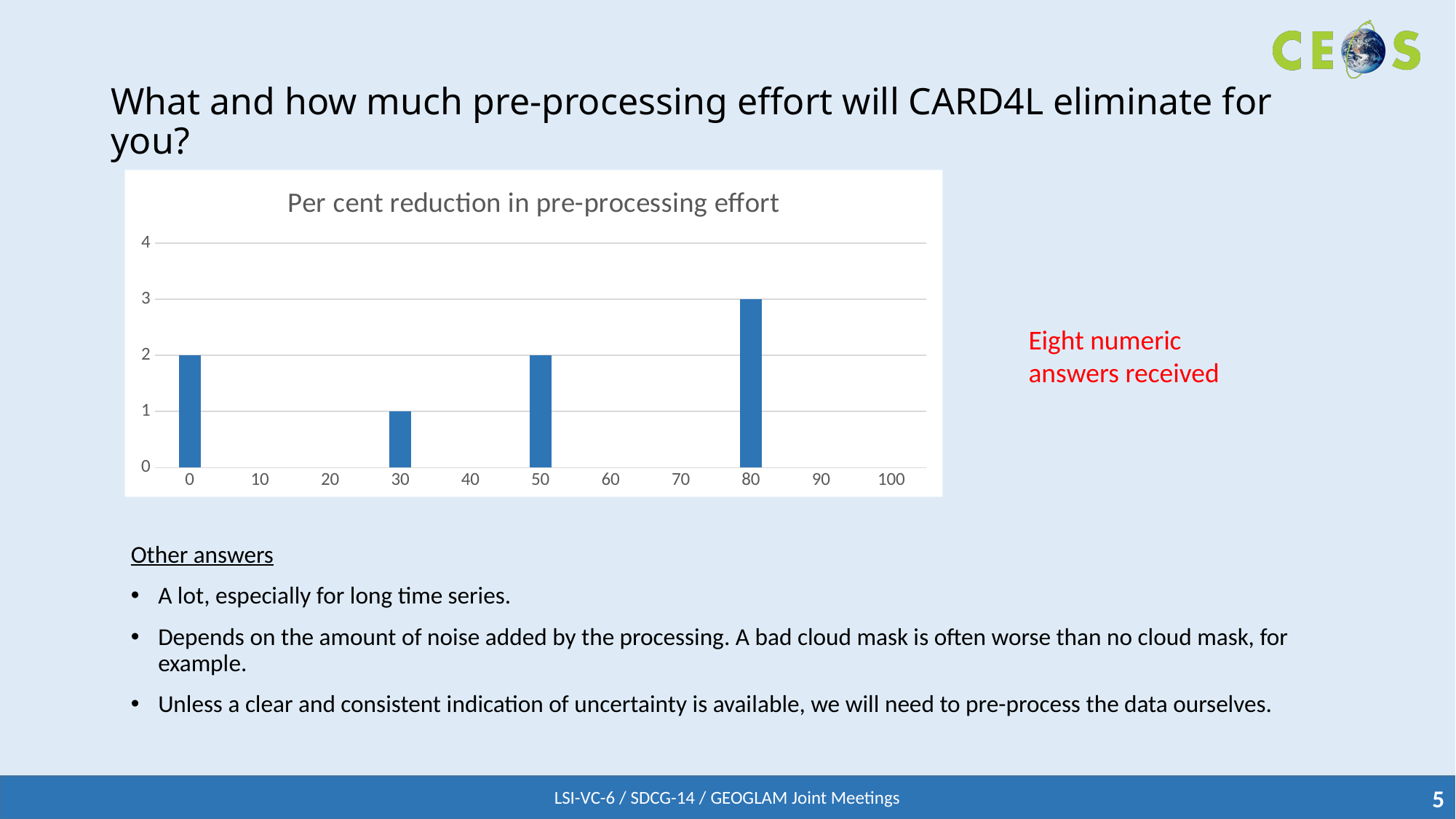
Among the categories with a bar, which has the lowest value? 30 What is the value of the bar at 50 in the chart? 2 Is the value of the bar at 80 greater or less than 2? greater How many tick labels are shown on the x axis of the chart? 11 What kind of chart is shown on the slide? Bar chart Which has the larger value, the bar at 0 or the bar at 30? 0 What is the value of the bar at 30 in the chart? 1 Which x-axis category has the tallest bar in the chart? 80 What is the title of the chart? Per cent reduction in pre-processing effort What is the difference between the bar at 80 and the bar at 30? 2 How many bars are plotted in the chart? 4 What is the value of the bar at 80 in the 'Per cent reduction in pre-processing effort' chart? 3